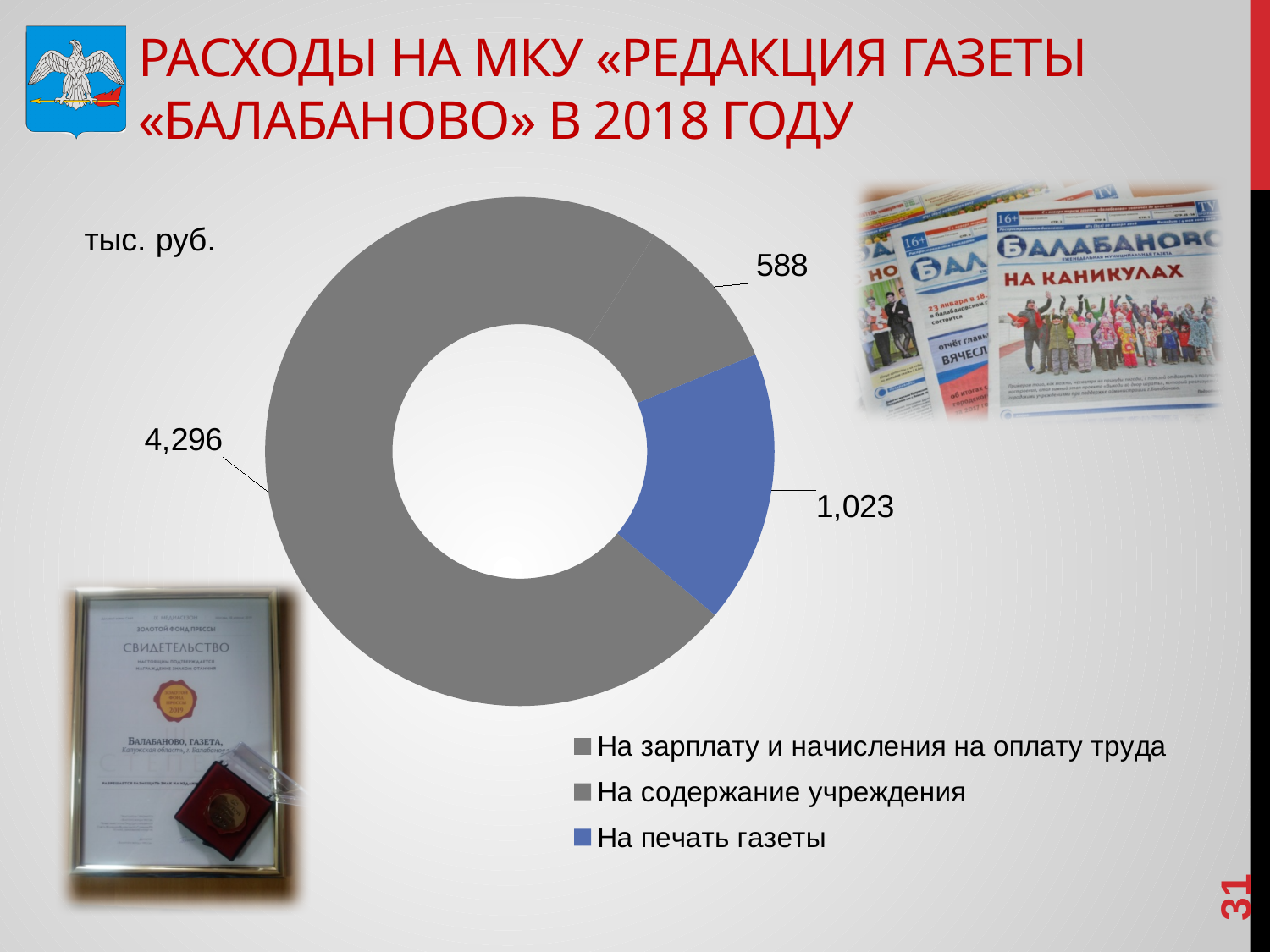
What type of chart is shown on the slide? Doughnut (pie) chart Which category has the largest value? На зарплату и начисления на оплату труда What is the total of all three slices? 5,907 Which category has the smallest value? На содержание учреждения How many categories does the chart show? 3 What is the value for «На печать газеты» (the blue slice)? 1,023 What is the difference between the largest slice (4,296) and the blue slice (1,023)? 3,273 How many entries does the legend list? 3 Which is larger: the value for «На печать газеты» or the value for «На содержание учреждения»? На печать газеты In what units are the values on the chart given? тыс. руб. What is the value for «На содержание учреждения»? 588 What is the value for «На зарплату и начисления на оплату труда»? 4,296